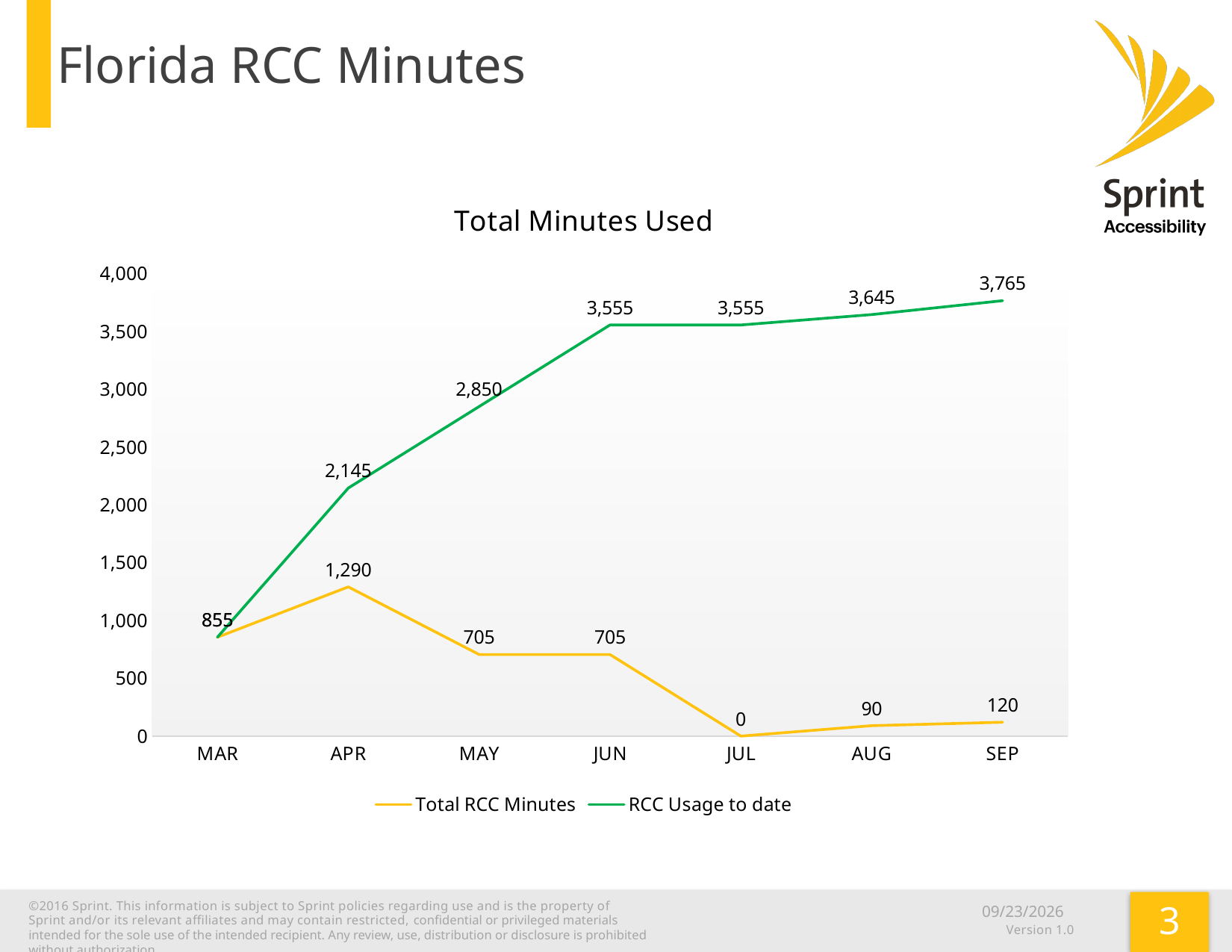
Does RCC Usage to date rise or fall from MAR to SEP? Rise Which month has the highest Total RCC Minutes? APR How many series does the legend list? 2 What is the difference between RCC Usage to date in SEP and in AUG? 120 How many months are shown on the x axis? 7 What kind of chart is shown on the slide? Line chart Which is larger: Total RCC Minutes in MAR or in MAY? MAR Is the value of RCC Usage to date for MAY greater or less than 2,500? greater What is the value of Total RCC Minutes for APR? 1,290 What is the value of RCC Usage to date for SEP? 3,765 Which month has the lowest Total RCC Minutes? JUL What is the value of Total RCC Minutes for JUL? 0